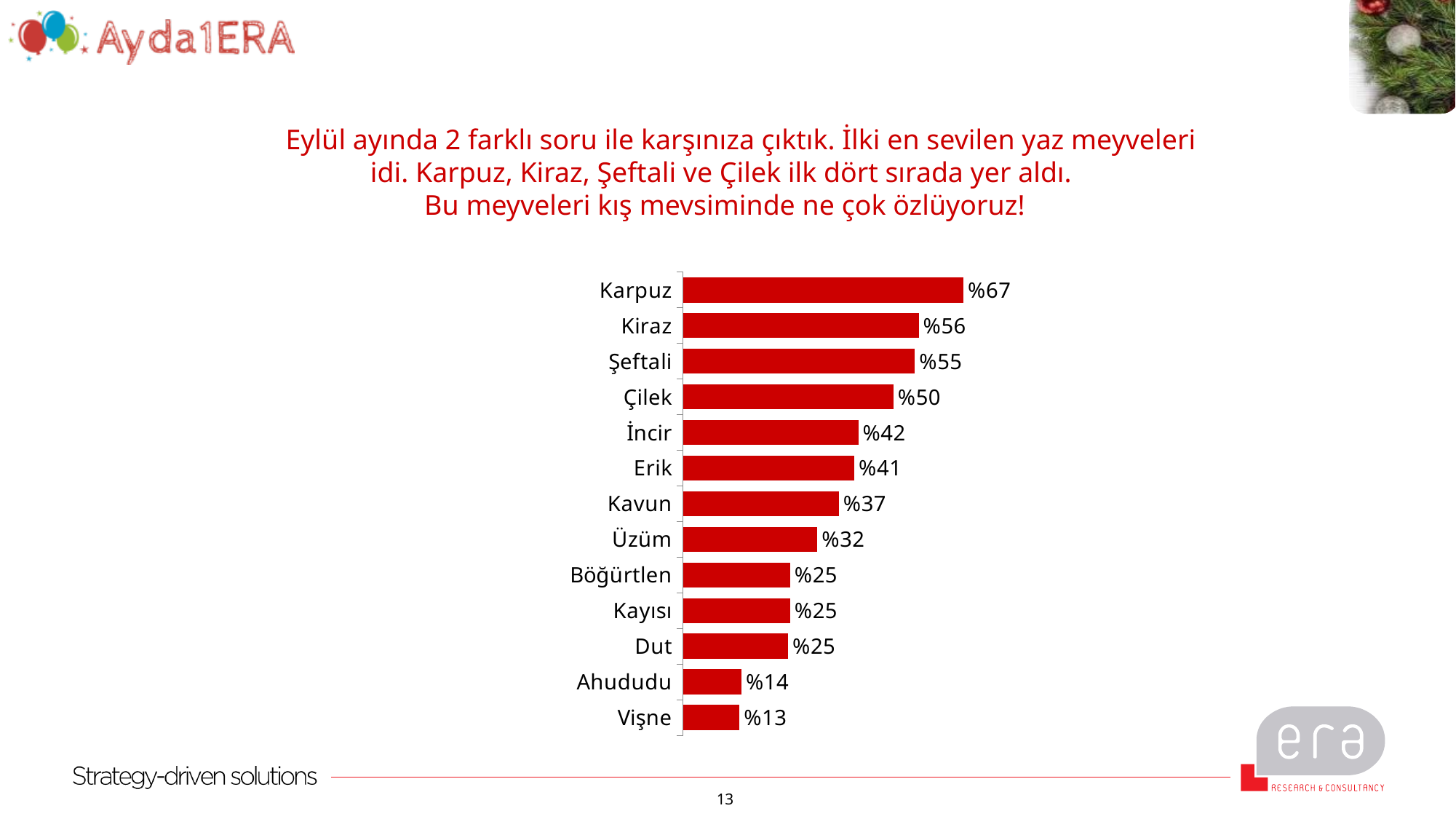
Which category has the lowest value? Vişne What is the difference between the values for Çilek and Ahududu? %36 What is the value for Karpuz? %67 What is the difference between the values for Karpuz and Kiraz? %11 What kind of chart is shown on the slide? Bar chart What colour are the bars in the chart? Red What is the value for Üzüm? %32 Which category has the highest value? Karpuz What is the value for İncir? %42 Which is larger, the value for Erik or the value for Böğürtlen? Erik How many categories are shown in the chart? 13 Which is larger, the value for Kavun or the value for Üzüm? Kavun